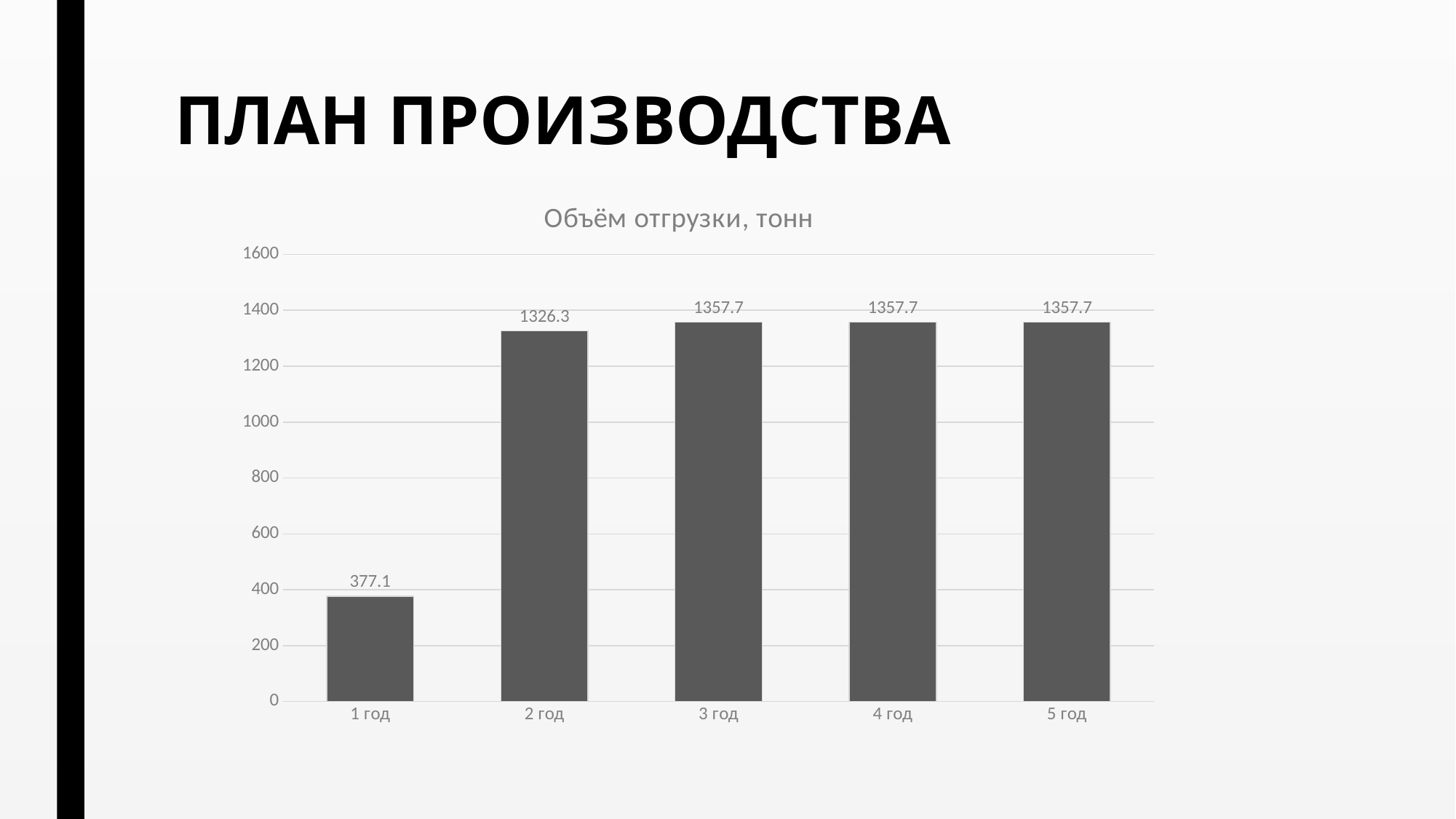
What is the value for 4 год? 1357.7 Is the value for 5 год greater or less than 1200? greater How many categories are shown on the x axis? 5 What is the difference between the values for 2 год and 1 год? 949.2 What is the value for 2 год? 1326.3 What is the title of the chart? Объём отгрузки, тонн What kind of chart is shown on the slide? bar chart Which category has the lowest value? 1 год What is the difference between the values for 3 год and 2 год? 31.4 What is the value for 1 год? 377.1 Which is larger, the value for 1 год or the value for 2 год? 2 год Is the value for 1 год greater or less than 400? less